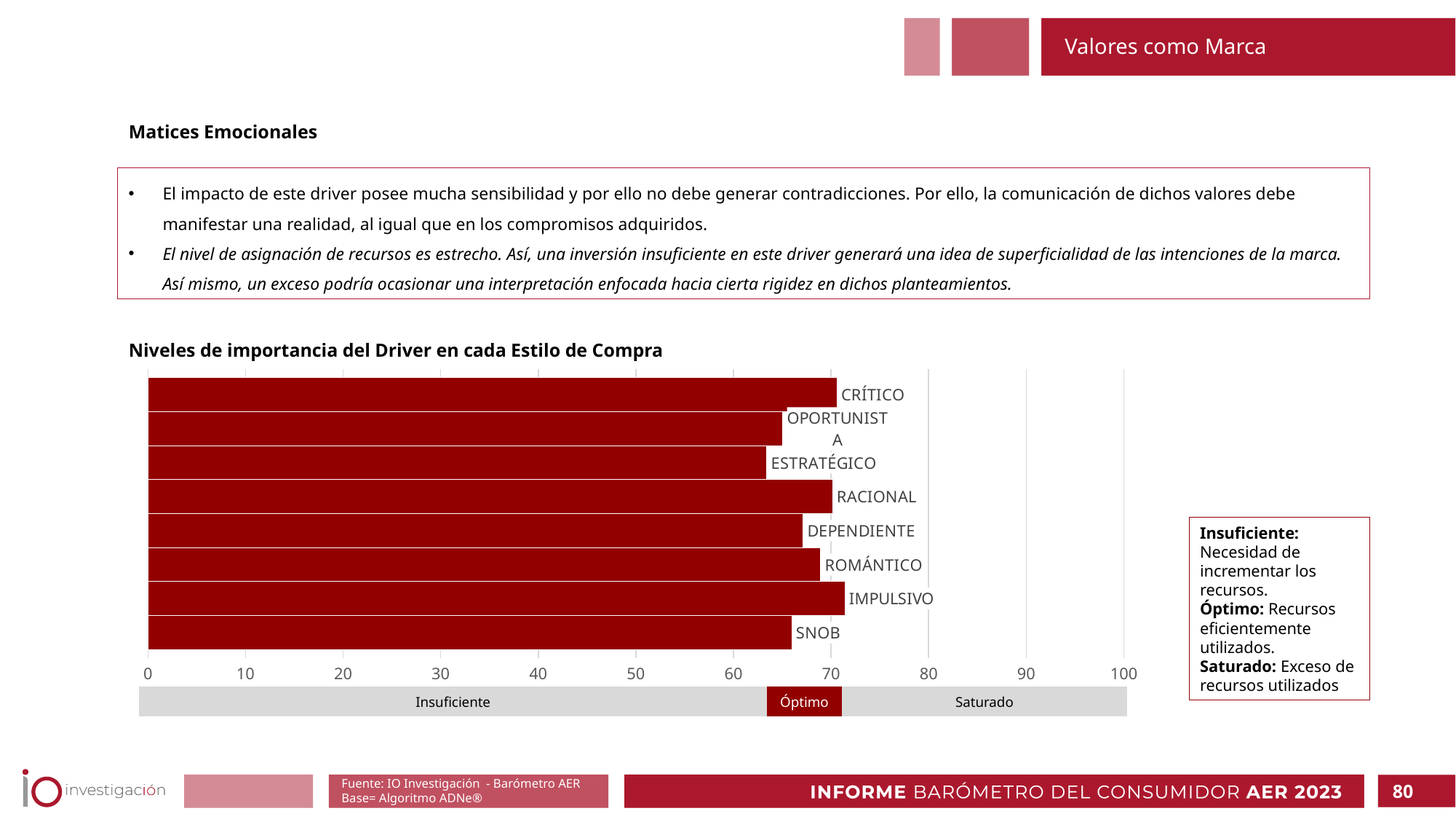
Is the value for IMPULSIVO greater or less than 70? greater Is the value for DEPENDIENTE greater or less than 70? less Which has the larger value, CRÍTICO or OPORTUNISTA? CRÍTICO Is the value for ESTRATÉGICO greater or less than 60? greater Which has the larger value, DEPENDIENTE or ESTRATÉGICO? DEPENDIENTE What kind of chart is shown under 'Niveles de importancia del Driver en cada Estilo de Compra'? Bar chart What is the title of the bar chart on the slide? Niveles de importancia del Driver en cada Estilo de Compra How many purchase styles (categories) are plotted in the bar chart? 8 What are the three zone labels shown beneath the chart's x axis? Insuficiente, Óptimo, Saturado Which has the larger value, IMPULSIVO or ESTRATÉGICO? IMPULSIVO